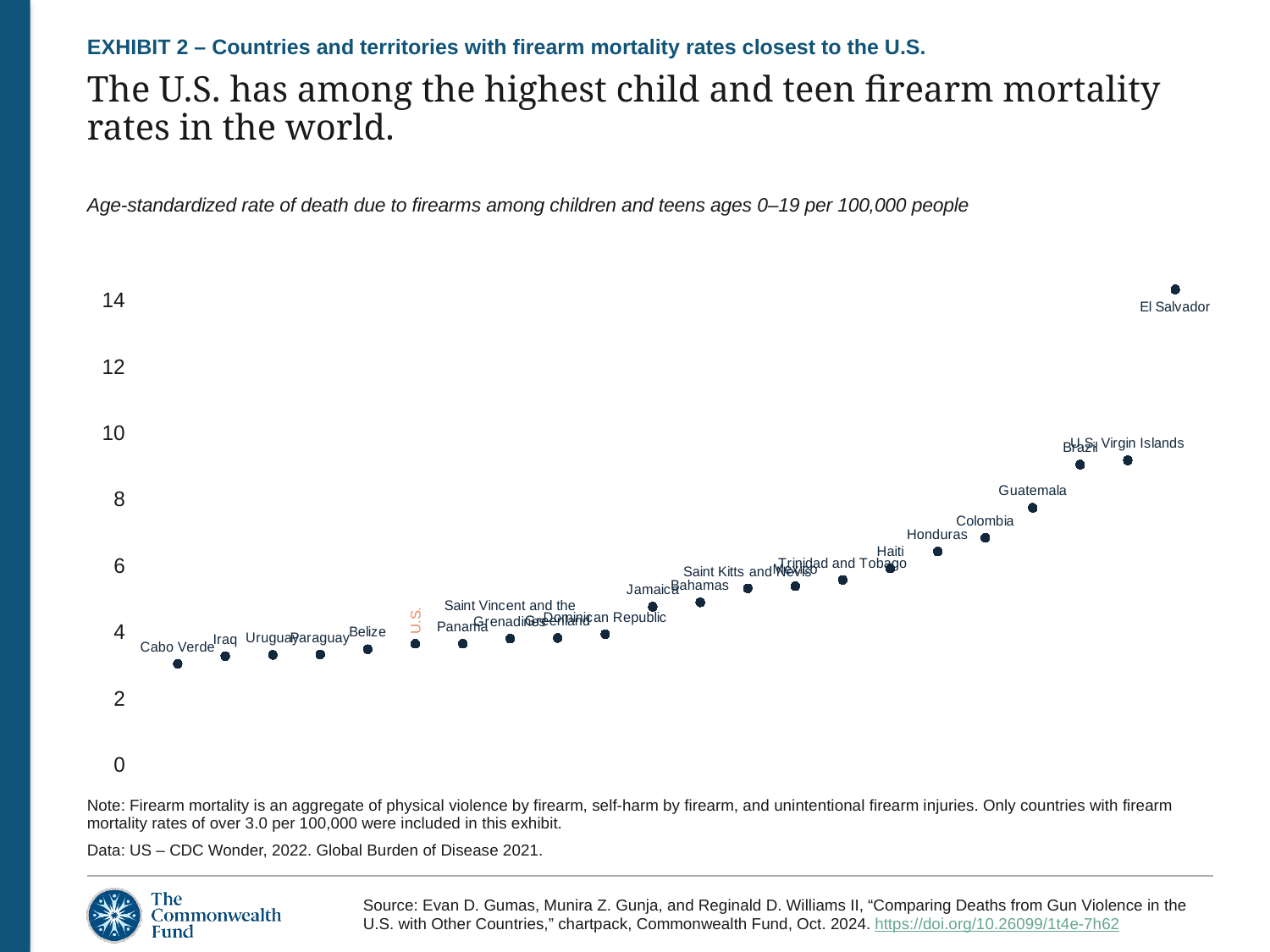
Which country has the highest firearm mortality rate on the chart? El Salvador Do the values rise or fall moving from left to right along the x axis? rise Is the value for Brazil greater or less than 10? less Is the value for Honduras greater or less than 6? greater Is the value for Cabo Verde greater or less than 4? less Which has a higher firearm mortality rate, Guatemala or Colombia? Guatemala What measure does the chart plot, according to the subtitle? Age-standardized rate of death due to firearms among children and teens ages 0–19 per 100,000 people What kind of chart is shown on the slide? scatter (dot) chart Which country has the lowest firearm mortality rate on the chart? Cabo Verde